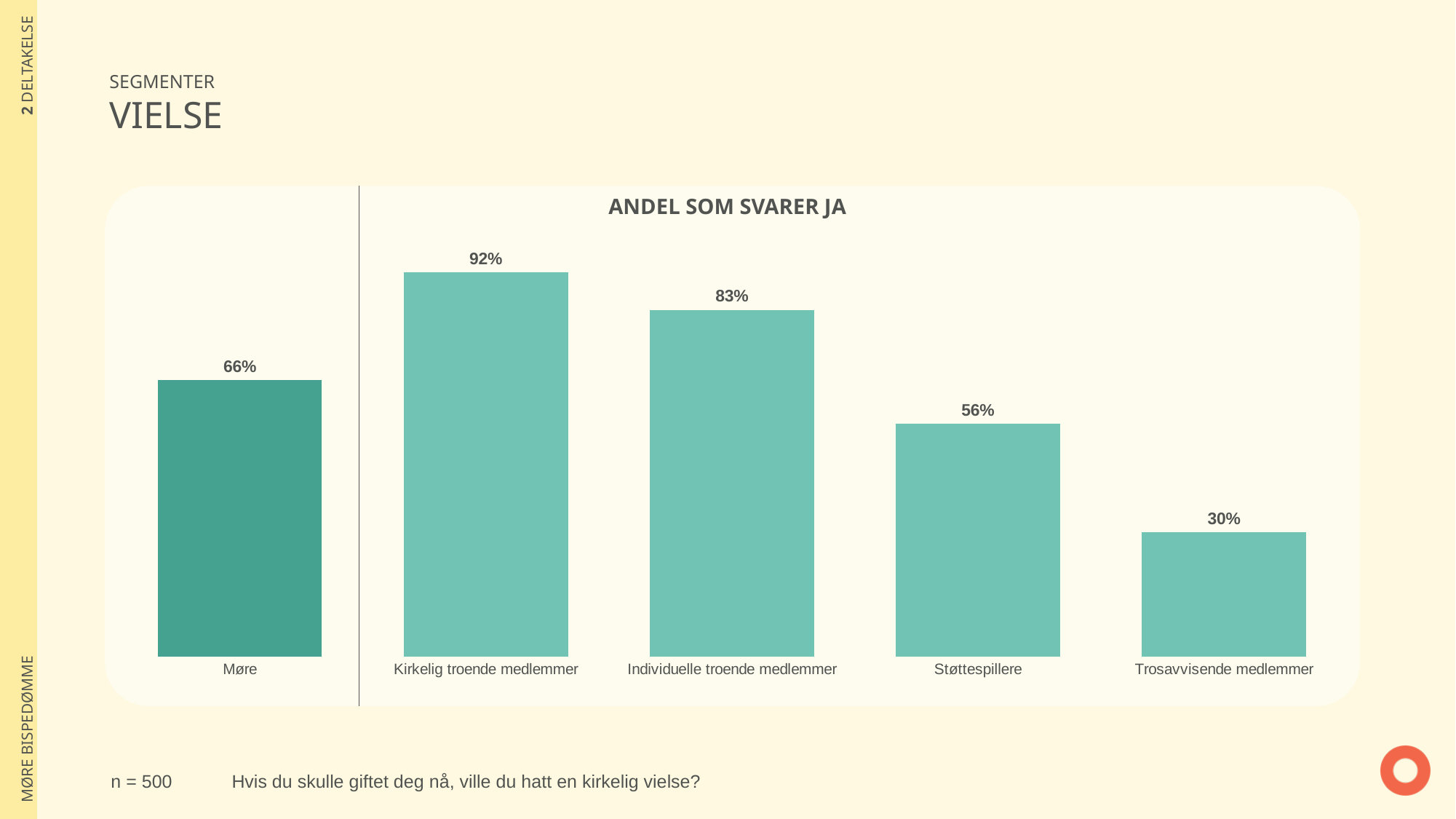
Which category has the lowest value? Trosavvisende medlemmer What kind of chart is shown on the slide? Bar chart What is the difference between the values for Møre and Trosavvisende medlemmer? 36% What is the value for Kirkelig troende medlemmer? 92% Which is larger, the value for Støttespillere or the value for Møre? Møre What is the value for Møre? 66% What is the value for Støttespillere? 56% Which category has the highest value? Kirkelig troende medlemmer What is the title of the chart? ANDEL SOM SVARER JA What is the difference between the values for Kirkelig troende medlemmer and Individuelle troende medlemmer? 9% What is the value for Trosavvisende medlemmer? 30% How many categories are shown in the chart? 5